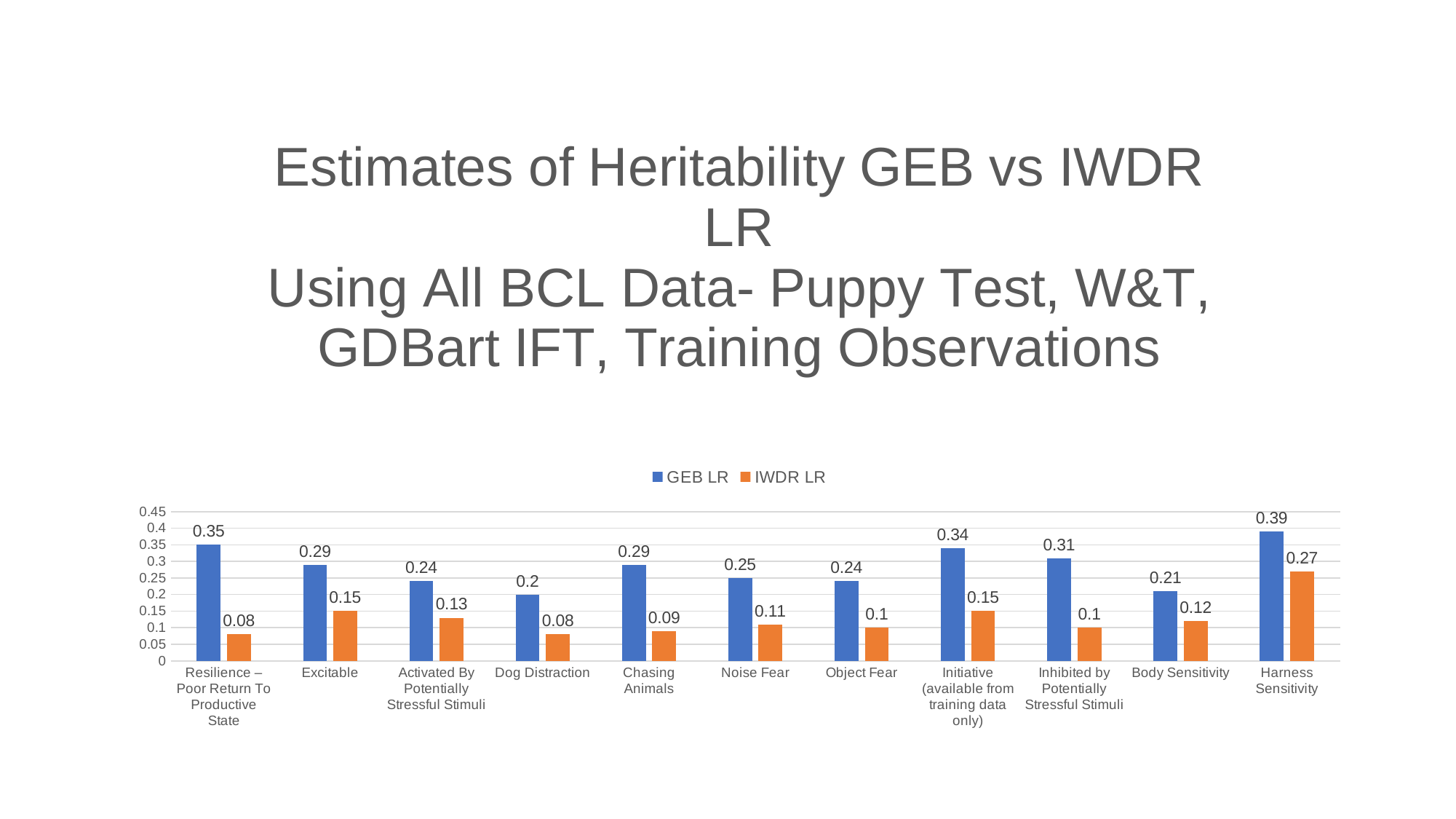
What is the GEB LR value for Dog Distraction? 0.2 How many series does the legend list? 2 What is the GEB LR value for Harness Sensitivity? 0.39 Which category has the lowest GEB LR value? Dog Distraction What kind of chart is shown on the slide? Bar chart How many categories are shown on the x axis? 11 What colour are the IWDR LR bars? Orange Which is larger for Noise Fear, the GEB LR value or the IWDR LR value? GEB LR What is the IWDR LR value for Excitable? 0.15 Which category has the highest GEB LR value? Harness Sensitivity Which category has the highest IWDR LR value? Harness Sensitivity What is the difference between the GEB LR and IWDR LR values for Resilience – Poor Return To Productive State? 0.27